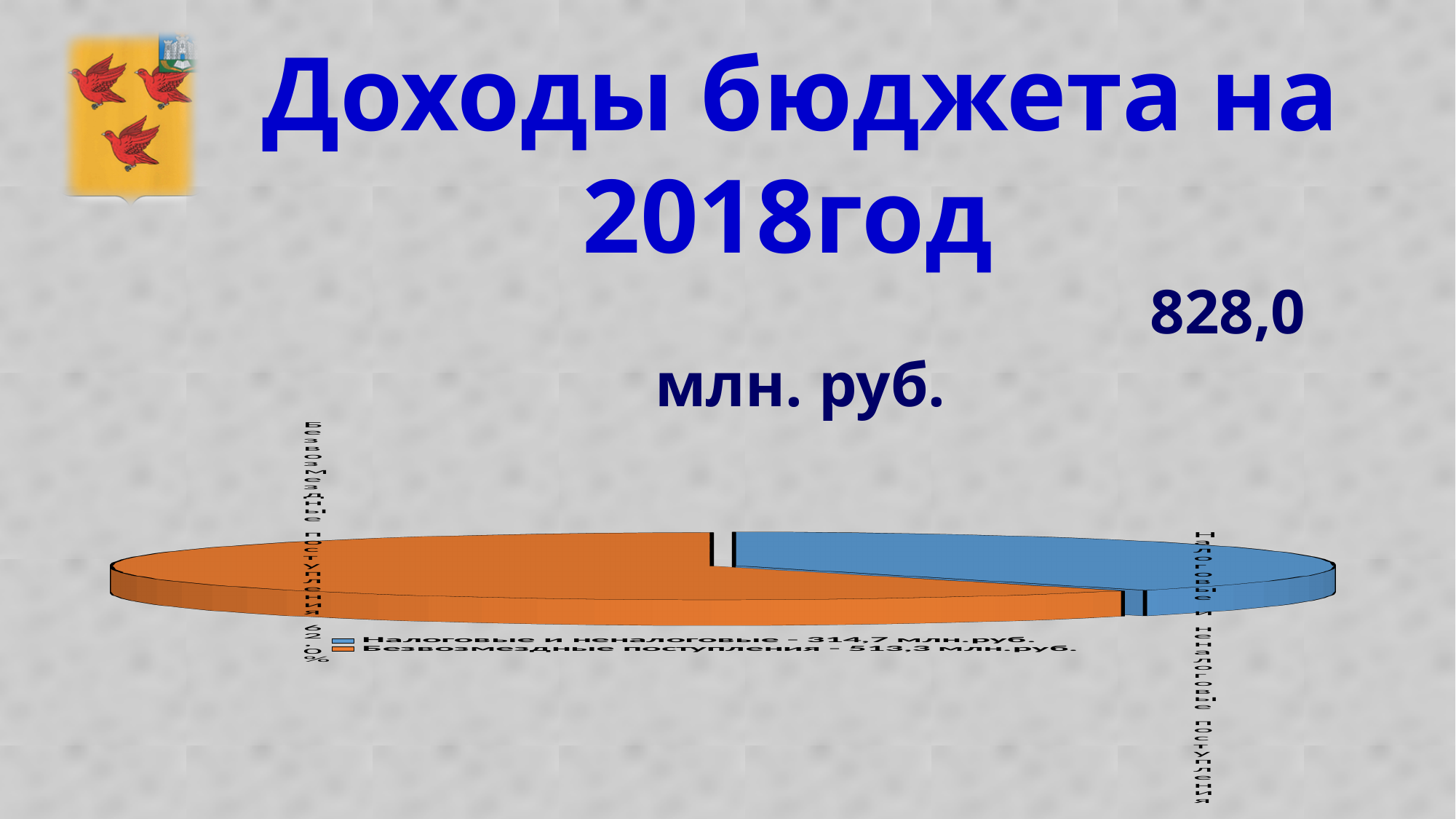
What value does the legend give for Налоговые и неналоговые? 314,7 млн.руб. How many slices does the pie chart have? 2 What kind of chart is shown on the slide? Pie chart Which category has the largest slice of the pie? Безвозмездные поступления What value does the legend give for Безвозмездные поступления? 513,3 млн.руб. What is the total budget income shown on the slide? 828,0 млн. руб. How many entries does the legend of the pie chart list? 2 What colour is the Безвозмездные поступления slice? Orange What is the difference between Безвозмездные поступления and Налоговые и неналоговые in млн.руб.? 198,6 Which is larger: Безвозмездные поступления or Налоговые и неналоговые? Безвозмездные поступления What share of the pie does the Безвозмездные поступления slice represent, as labelled on the chart? 62,0% Which category has the smallest slice of the pie? Налоговые и неналоговые